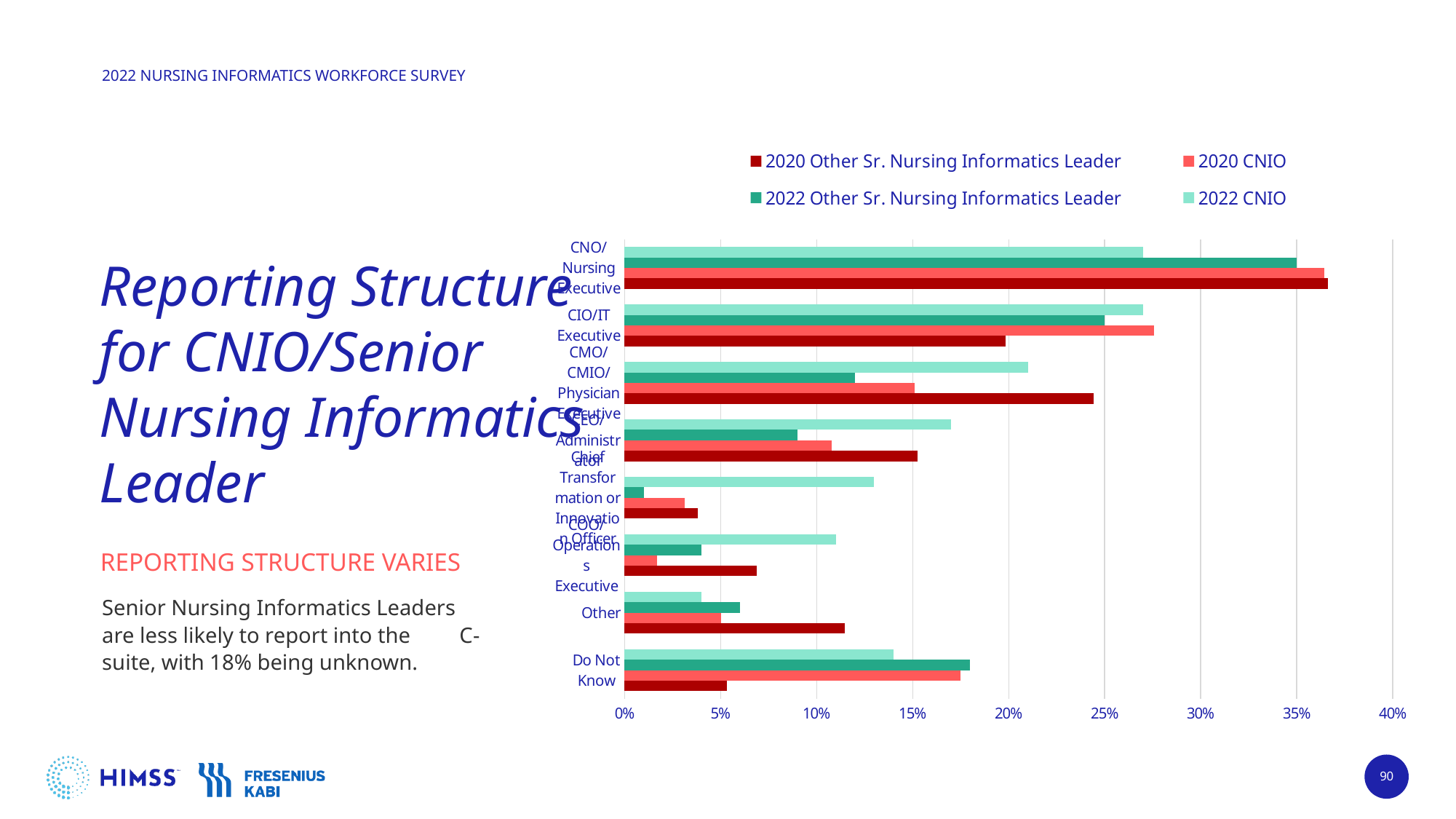
How many reporting-structure categories are plotted on the chart? 8 Which category has the highest value for 2020 Other Sr. Nursing Informatics Leader? CNO/Nursing Executive Is the 2020 Other Sr. Nursing Informatics Leader value for Do Not Know greater or less than 10%? less Which series is shown in dark red in the legend? 2020 Other Sr. Nursing Informatics Leader Which category has the lowest value for 2022 Other Sr. Nursing Informatics Leader? Chief Transformation or Innovation Officer For Do Not Know, which is larger: the 2022 Other Sr. Nursing Informatics Leader value or the 2020 Other Sr. Nursing Informatics Leader value? 2022 Other Sr. Nursing Informatics Leader How many series does the chart legend list? 4 What kind of chart is shown on the slide? Bar chart Is the 2022 CNIO value for Chief Transformation or Innovation Officer greater or less than 10%? greater Is the 2022 CNIO value for CNO/Nursing Executive greater or less than 25%? greater For CMO/CMIO/Physician Executive, which is larger: the 2020 Other Sr. Nursing Informatics Leader value or the 2022 Other Sr. Nursing Informatics Leader value? 2020 Other Sr. Nursing Informatics Leader